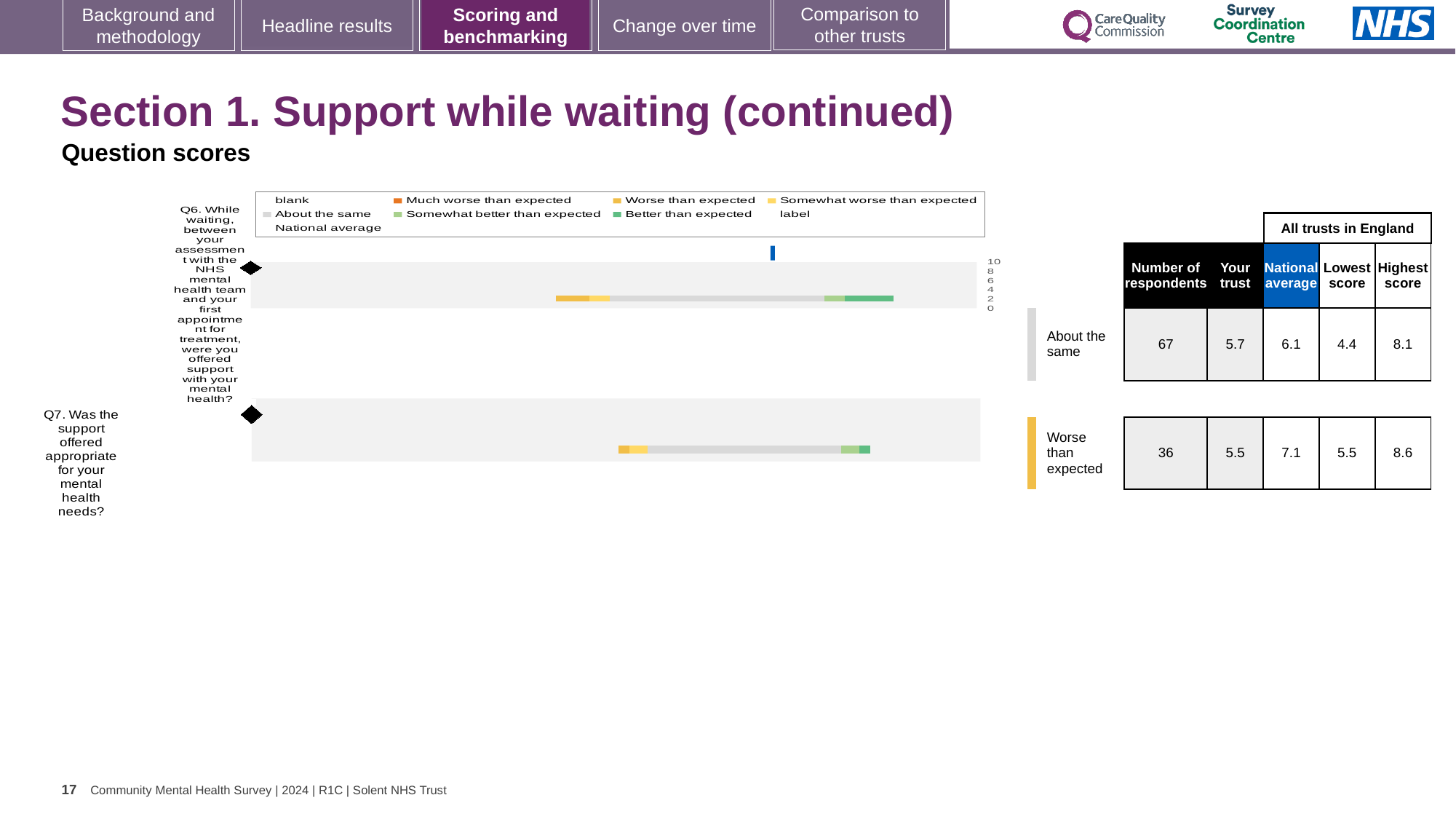
What is the 'Your trust' score for Q7 (was the support offered appropriate for your mental health needs)? 5.5 Which question has the higher 'Your trust' score, Q6 or Q7? Q6 What kind of chart is used to show the question scores on this slide? bar chart How many respondents answered Q6? 67 What benchmark category is Q7 assigned to on this slide? Worse than expected How many questions are plotted in the chart on this slide? 2 What is the 'Your trust' score for Q6 (support while waiting between assessment and first appointment)? 5.7 What is the national average score for Q6? 6.1 What is the highest score among all trusts in England for Q7? 8.6 What is the difference between the national average and the trust's score for Q7? 1.6 How many respondents answered Q7? 36 What is the national average score for Q7? 7.1